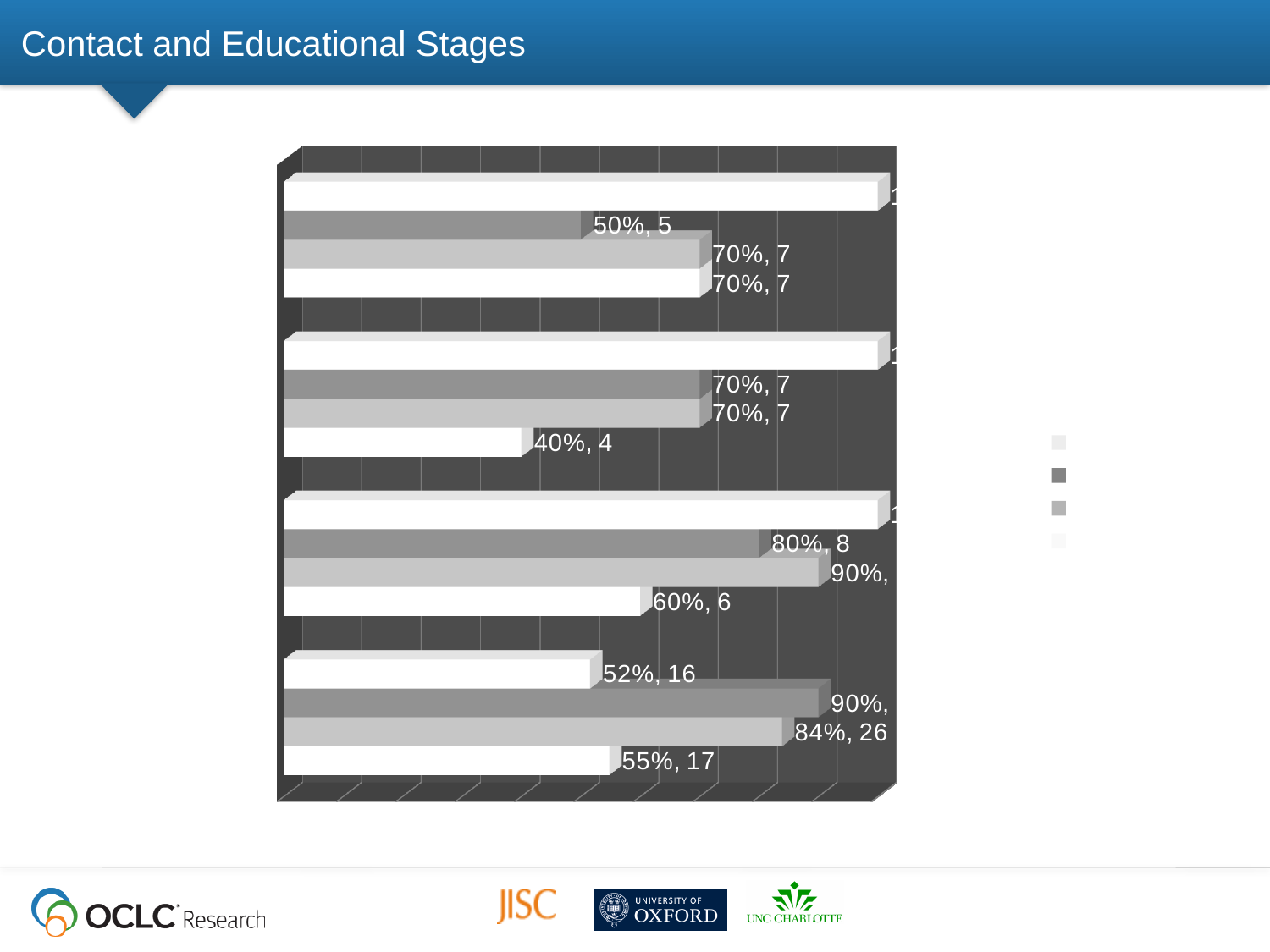
In the bottom group, which bar is the shortest: the top bar or the third bar from the top? The top bar What is the data label on the second bar from the top in the third group from the top? 80%, 8 How many bars are in each group of the chart? 4 How many groups of bars does the chart contain? 4 How many colour swatches does the legend to the right of the chart show? 4 What is the data label on the third bar from the top in the bottom group? 84%, 26 What is the data label on the bottom bar of the bottom group? 55%, 17 What kind of chart is shown on the slide? Bar chart In the bottom group, what is the difference in percentage between the third bar from the top (84%) and the top bar (52%)? 32% Is the chart drawn with a 3D effect? Yes What is the data label on the top bar of the bottom group? 52%, 16 What is the data label on the bottom bar of the second group from the top? 40%, 4